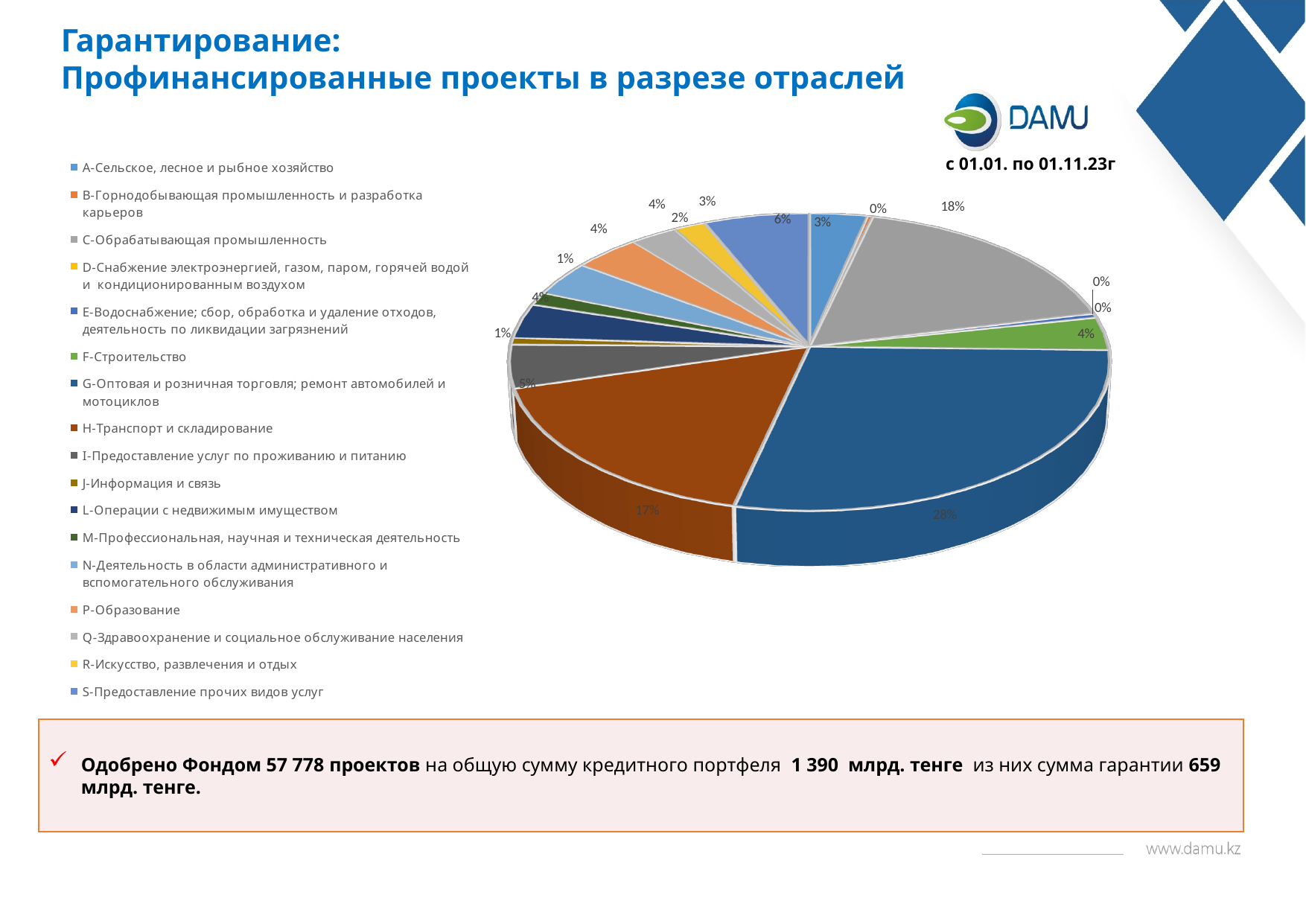
What share of the pie does G-Оптовая и розничная торговля; ремонт автомобилей и мотоциклов have? 28% What share of the pie does F-Строительство have? 4% How many categories does the legend of the pie chart list? 17 What kind of chart is shown on the slide? pie chart By how many percentage points does the share of G-Оптовая и розничная торговля exceed the share of H-Транспорт и складирование? 11 percentage points What share of the pie does S-Предоставление прочих видов услуг have? 6% What period is stated above the pie chart? с 01.01. по 01.11.23г Which is larger: the share of C-Обрабатывающая промышленность or the share of H-Транспорт и складирование? C-Обрабатывающая промышленность Which category has the largest share of the pie chart? G-Оптовая и розничная торговля; ремонт автомобилей и мотоциклов